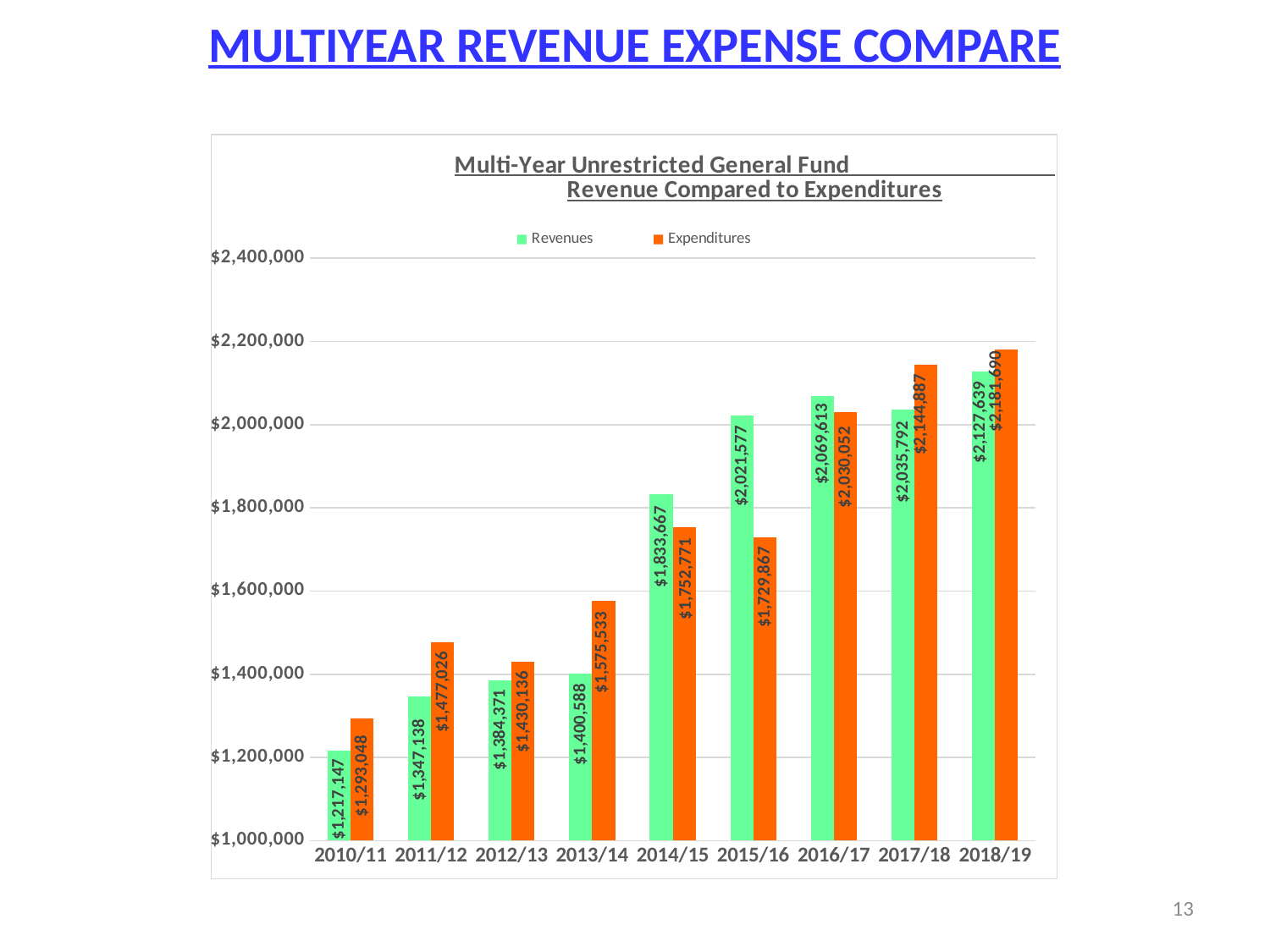
What is the Expenditures value for 2013/14? $1,575,533 Which year has the lowest Expenditures value? 2010/11 What is the Expenditures value for 2017/18? $2,144,887 What is the Revenues value for 2010/11? $1,217,147 How many series does the legend list? 2 What is the Revenues value for 2014/15? $1,833,667 What kind of chart is shown on the slide? Bar chart What is the difference between Revenues and Expenditures in 2014/15? $80,896 In 2015/16, which is larger, Revenues or Expenditures? Revenues Which year has the highest Revenues value? 2018/19 How many fiscal years are shown on the x axis? 9 What is the difference between Expenditures and Revenues in 2018/19? $54,051